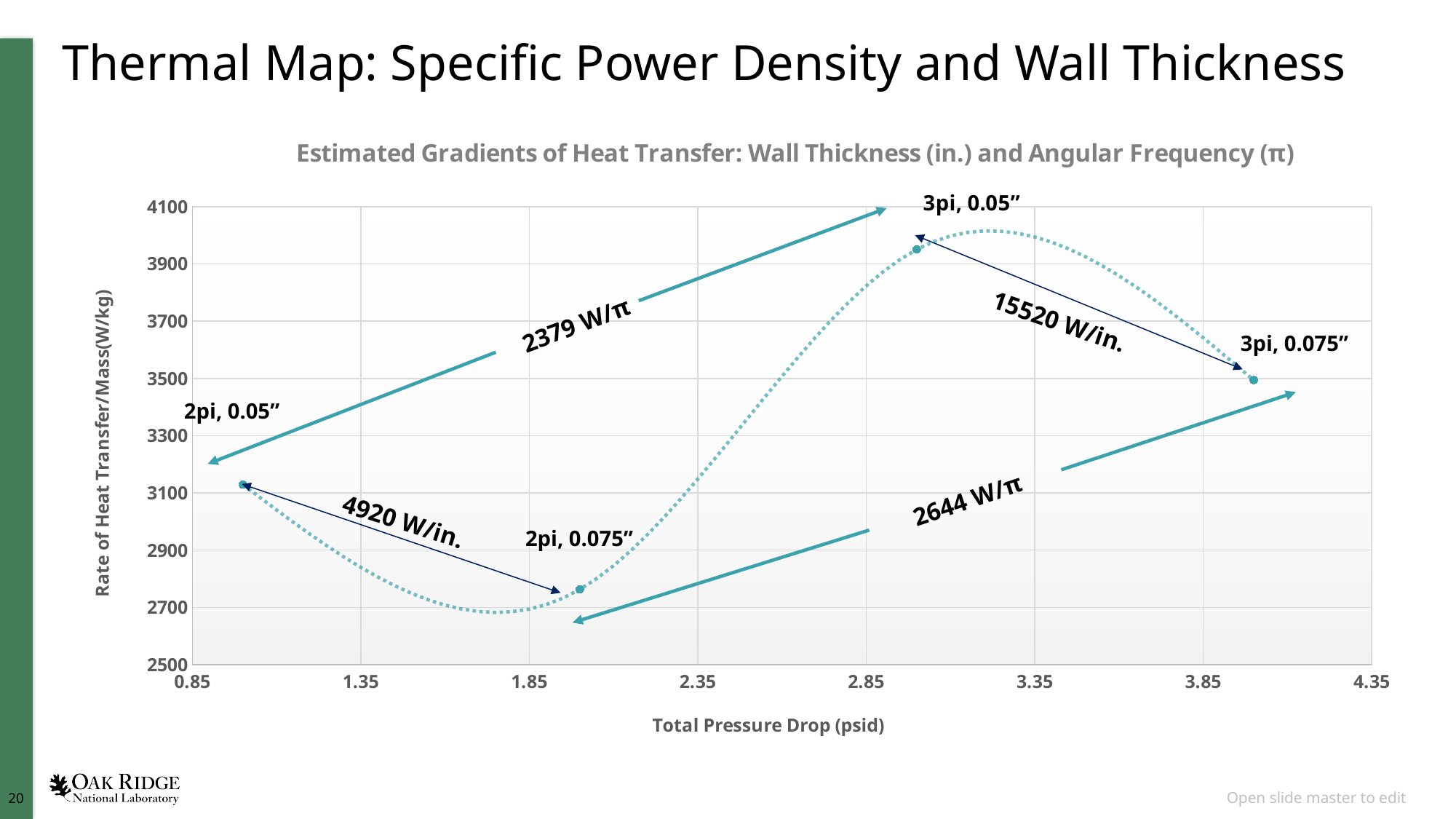
What is the label of the x axis? Total Pressure Drop (psid) Which labeled point has the highest Rate of Heat Transfer/Mass? 3pi, 0.05" How many data points are plotted on the chart? 4 What kind of chart is shown on the slide? Scatter chart What gradient value is printed on the arrow between the 3pi, 0.05" and 3pi, 0.075" points? 15520 W/in. Is the Rate of Heat Transfer/Mass for the 3pi, 0.05" point greater or less than 3900? greater Which point has a higher Rate of Heat Transfer/Mass: 2pi, 0.05" or 3pi, 0.075"? 3pi, 0.075" What is the title of the chart? Estimated Gradients of Heat Transfer: Wall Thickness (in.) and Angular Frequency (π) Is the Total Pressure Drop for the 3pi, 0.075" point greater or less than 3.85 psid? greater Is the Rate of Heat Transfer/Mass for the 2pi, 0.075" point greater or less than 2900? less What gradient value is printed on the arrow between the 2pi, 0.05" and 2pi, 0.075" points? 4920 W/in. Which labeled point has the lowest Rate of Heat Transfer/Mass? 2pi, 0.075"